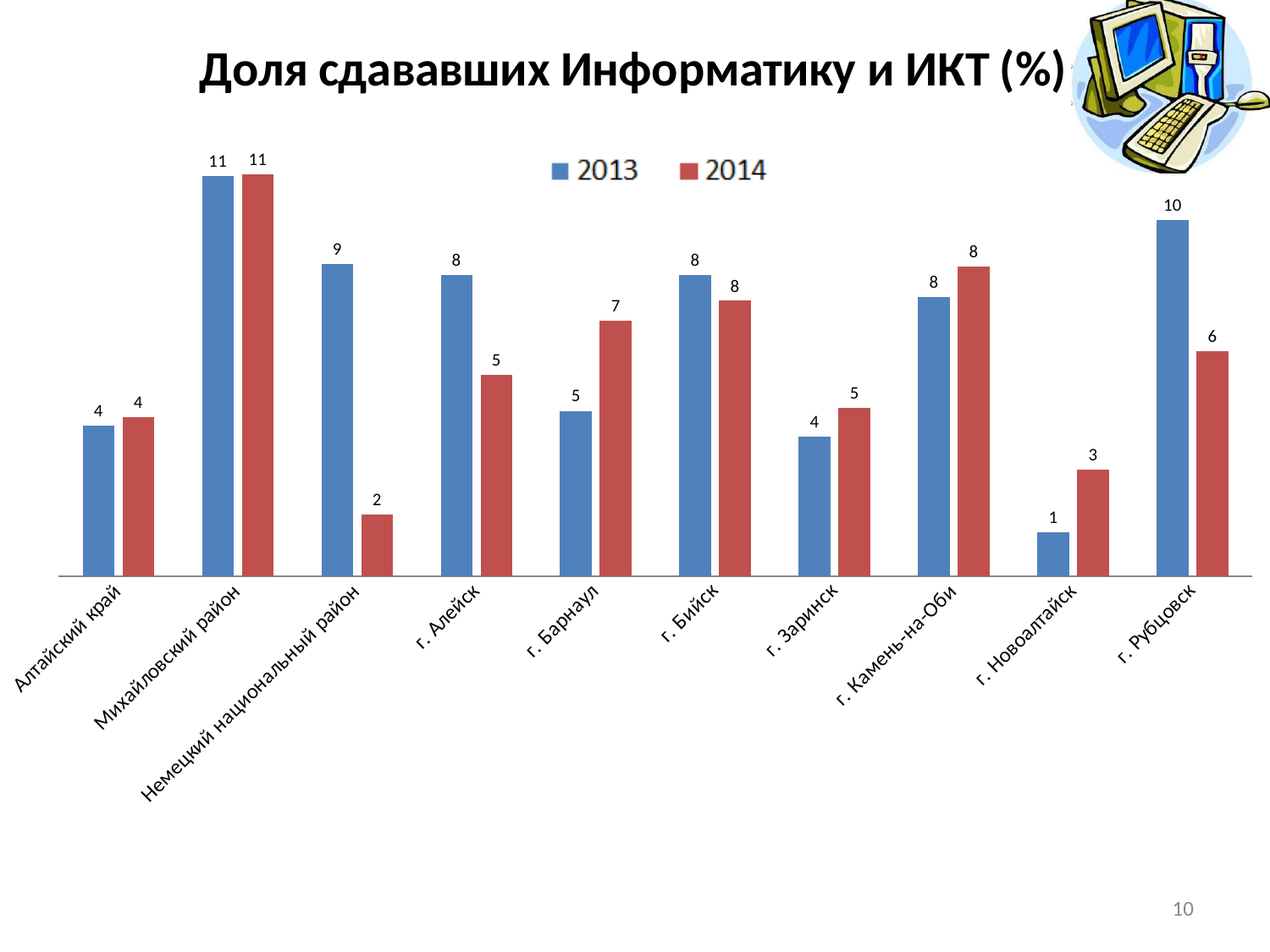
What is the difference between the 2013 and 2014 values for Немецкий национальный район? 7 What is the 2014 value for г. Новоалтайск? 3 Which category has the lowest 2013 value? г. Новоалтайск What is the 2014 value for г. Барнаул? 7 What is the difference between the 2013 and 2014 values for г. Рубцовск? 4 Which category has the lowest 2014 value? Немецкий национальный район Which category has the highest 2013 value? Михайловский район How many series does the legend list? 2 How many categories are shown on the x axis? 10 What is the 2013 value for Немецкий национальный район? 9 For г. Алейск, which year has the larger value, 2013 or 2014? 2013 What kind of chart is shown on the slide? Bar chart